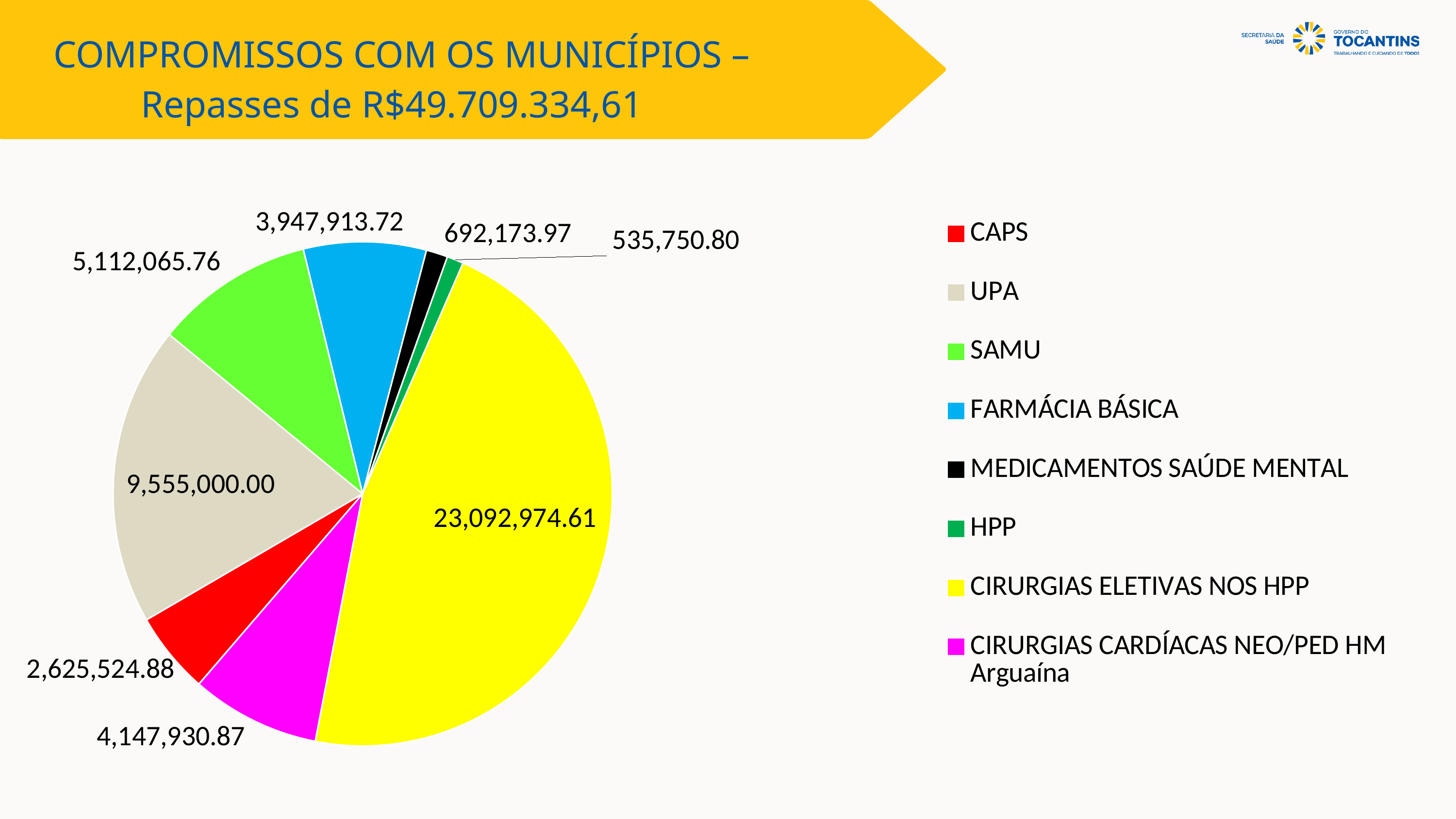
What is the difference between the MEDICAMENTOS SAÚDE MENTAL value and the HPP value? 156,423.17 Which category has the smallest slice of the pie? HPP What kind of chart is shown on the slide? Pie chart How many categories does the pie chart show? 8 Which category has the largest slice of the pie? CIRURGIAS ELETIVAS NOS HPP What value is shown for the SAMU slice? 5,112,065.76 What is the difference between the UPA value and the SAMU value? 4,442,934.24 What value is shown for the CIRURGIAS ELETIVAS NOS HPP slice? 23,092,974.61 What value is shown for the HPP slice? 535,750.80 What value is shown for the UPA slice? 9,555,000.00 What value is shown for the CAPS slice? 2,625,524.88 Which is larger, the value for FARMÁCIA BÁSICA or the value for CIRURGIAS CARDÍACAS NEO/PED HM Arguaína? CIRURGIAS CARDÍACAS NEO/PED HM Arguaína